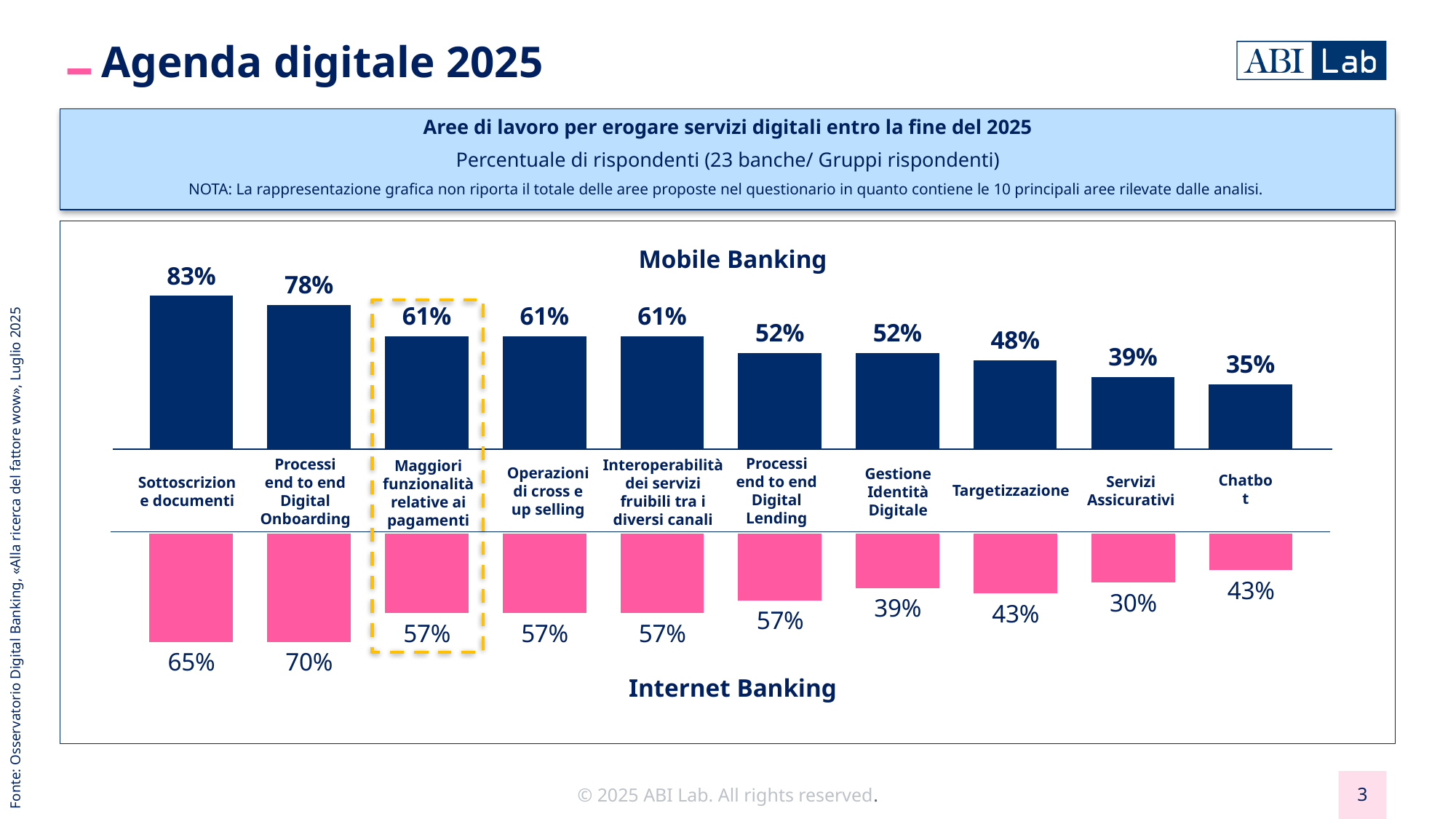
Which category is highlighted with a dashed yellow box? Maggiori funzionalità relative ai pagamenti What is the Mobile Banking value for Sottoscrizione e documenti? 83% Which category has the lowest Internet Banking value? Servizi Assicurativi What is the Internet Banking value for Processi end to end Digital Onboarding? 70% What kind of chart is shown on the slide? Bar chart Which category has the lowest Mobile Banking value? Chatbot How many categories are shown in the chart? 10 How many series does the chart show? 2 What is the Internet Banking value for Servizi Assicurativi? 30% Which category has the highest Mobile Banking value? Sottoscrizione e documenti What is the difference between the Mobile Banking and Internet Banking values for Sottoscrizione e documenti? 18% For Chatbot, which is larger: the Mobile Banking value or the Internet Banking value? Internet Banking